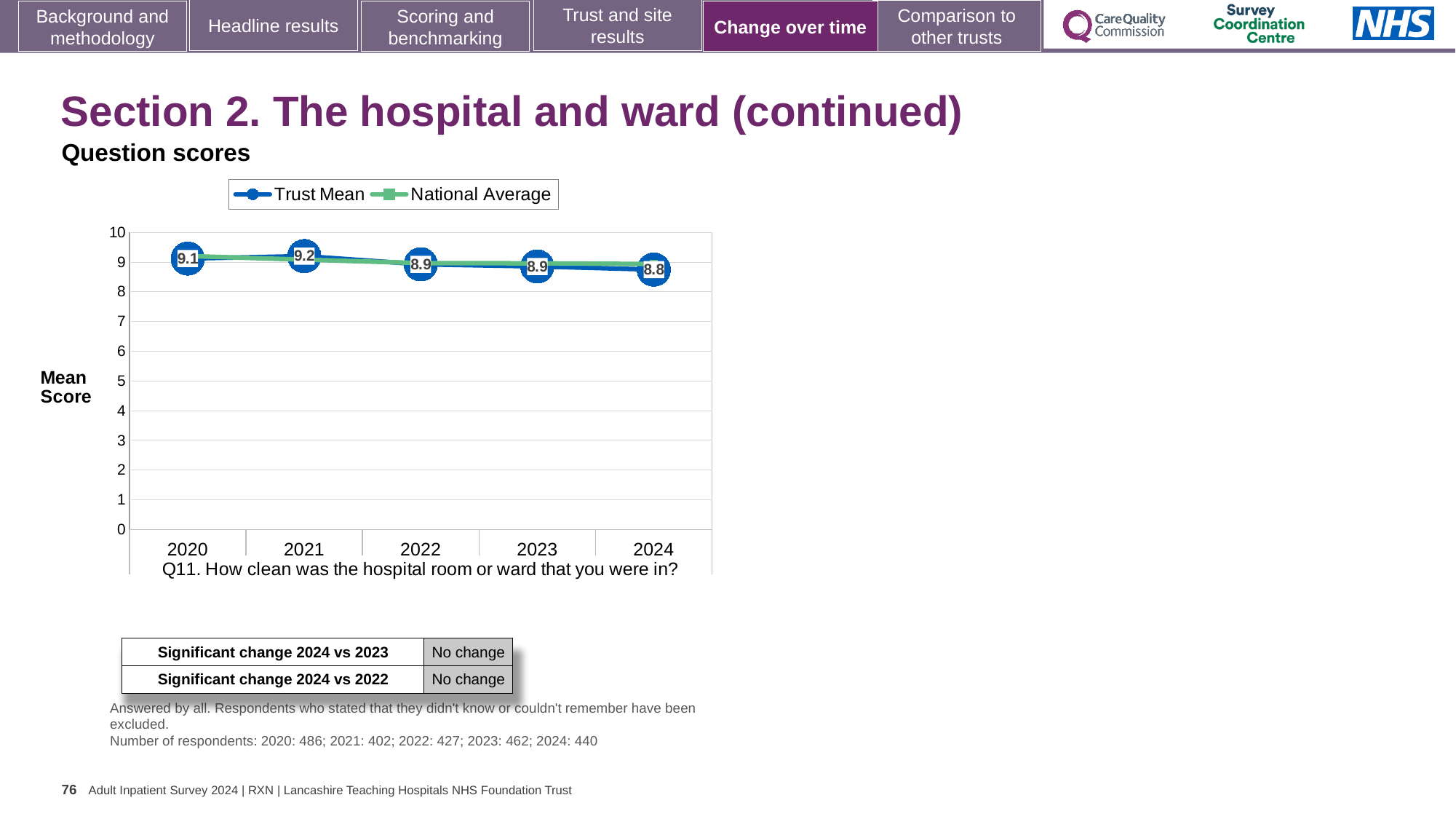
In which year is the Trust Mean score highest? 2021 How many series does the chart legend list? 2 What is the Trust Mean score for 2021? 9.2 In which year is the Trust Mean score lowest? 2024 Which is larger, the Trust Mean score for 2020 or for 2024? 2020 Does the Trust Mean score rise or fall from 2021 to 2024? fall What is the Trust Mean score for 2020? 9.1 What is the difference between the Trust Mean score in 2021 and in 2024? 0.4 Is the National Average value for 2024 greater or less than 8? greater How many years are shown on the x axis of the chart? 5 What is the Trust Mean score for 2024? 8.8 What kind of chart is shown on the slide? line chart